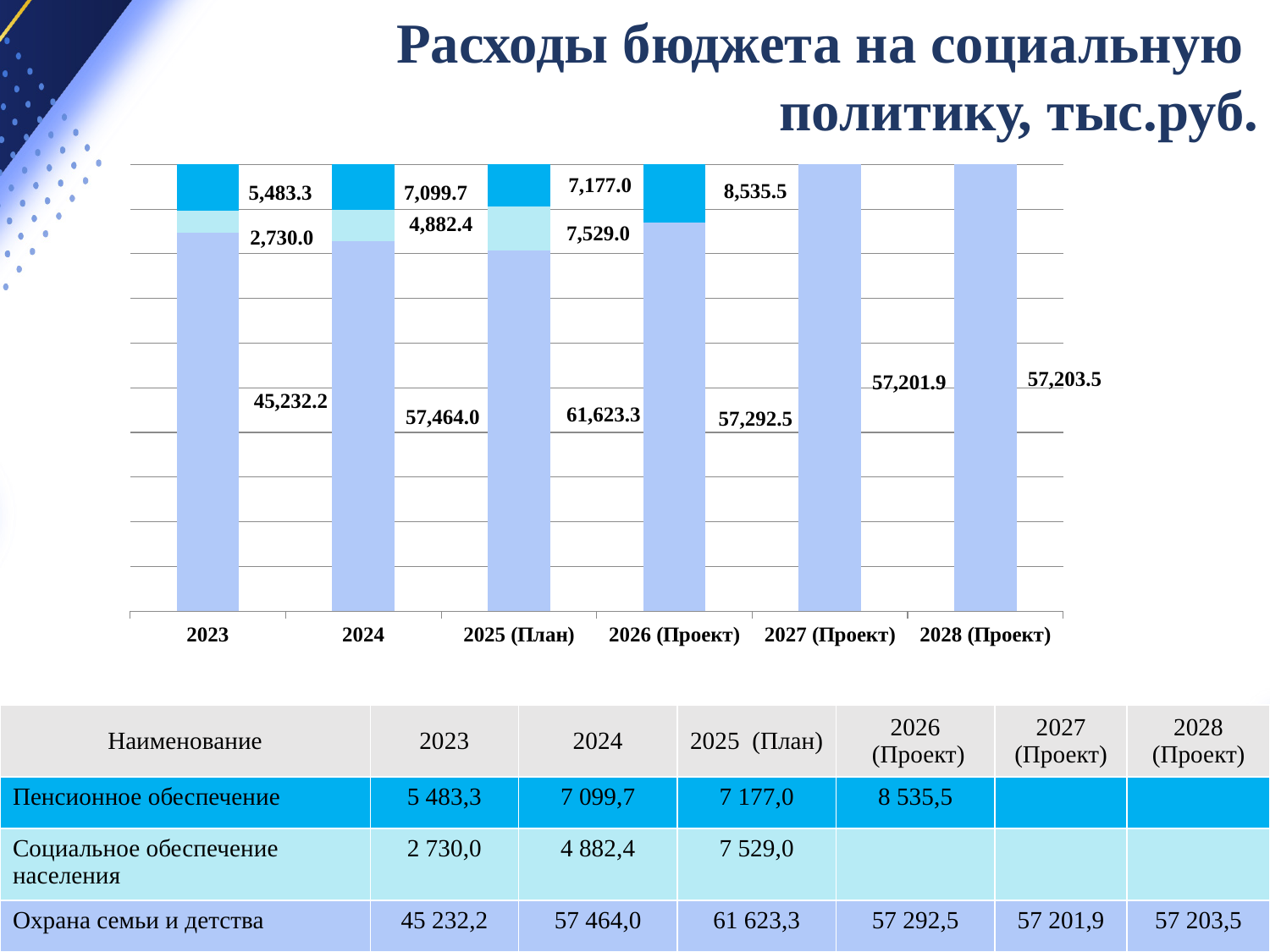
How many categories are shown on the x axis of the chart? 6 What is the title of the chart? Расходы бюджета на социальную политику, тыс.руб. Which is larger: the top segment value for 2024 or for 2025 (План)? 2025 (План) What is the value of the top segment of the bar for 2026 (Проект)? 8,535.5 What is the value shown for 2028 (Проект)? 57,203.5 Which category has the highest value for the bottom segment of the bars? 2025 (План) Which category has the lowest value for the bottom segment of the bars? 2023 What is the value of the bottom (largest) segment of the bar for 2023? 45,232.2 What is the difference between the bottom segment values for 2024 and 2023? 12,231.8 What is the value of the middle segment of the bar for 2025 (План)? 7,529.0 What kind of chart is shown on the slide? stacked bar chart What is the total of the stacked bar for 2023? 53,445.5